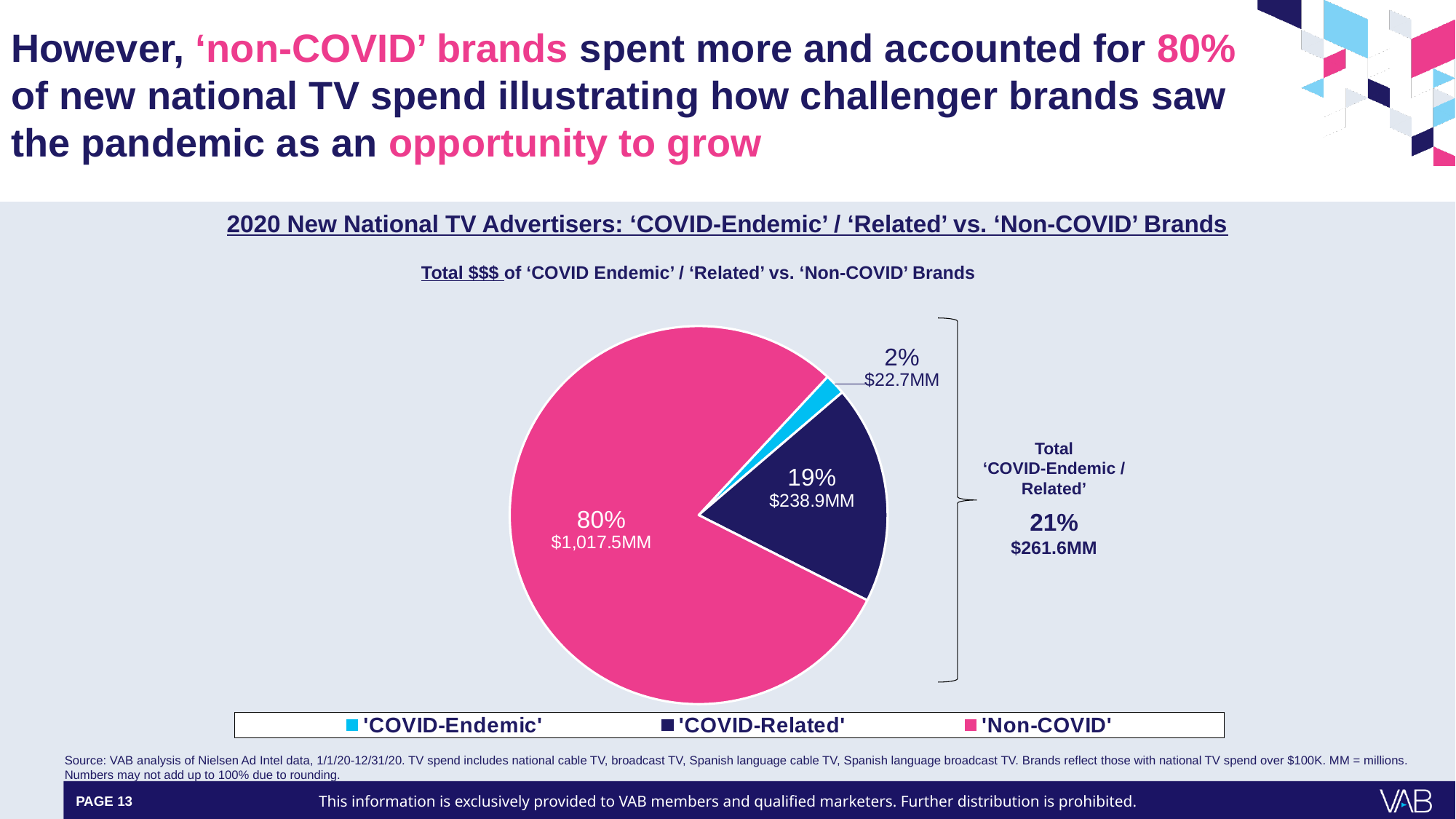
Which is larger, the 'COVID-Related' slice or the 'COVID-Endemic' slice? 'COVID-Related' Which category has the largest slice of the pie? 'Non-COVID' What is the difference in percentage points between the 'Non-COVID' share and the 'COVID-Related' share? 61 percentage points What is the dollar value shown for 'COVID-Endemic'? $22.7MM What is the combined total shown for 'COVID-Endemic / Related' brands? 21%, $261.6MM Which category has the smallest slice of the pie? 'COVID-Endemic' What kind of chart is shown on the slide? Pie chart What share of the pie does 'COVID-Endemic' account for? 2% What share of the pie does 'Non-COVID' account for? 80% What is the dollar value shown for 'COVID-Related'? $238.9MM What is the dollar value shown for 'Non-COVID'? $1,017.5MM How many categories does the legend list? 3